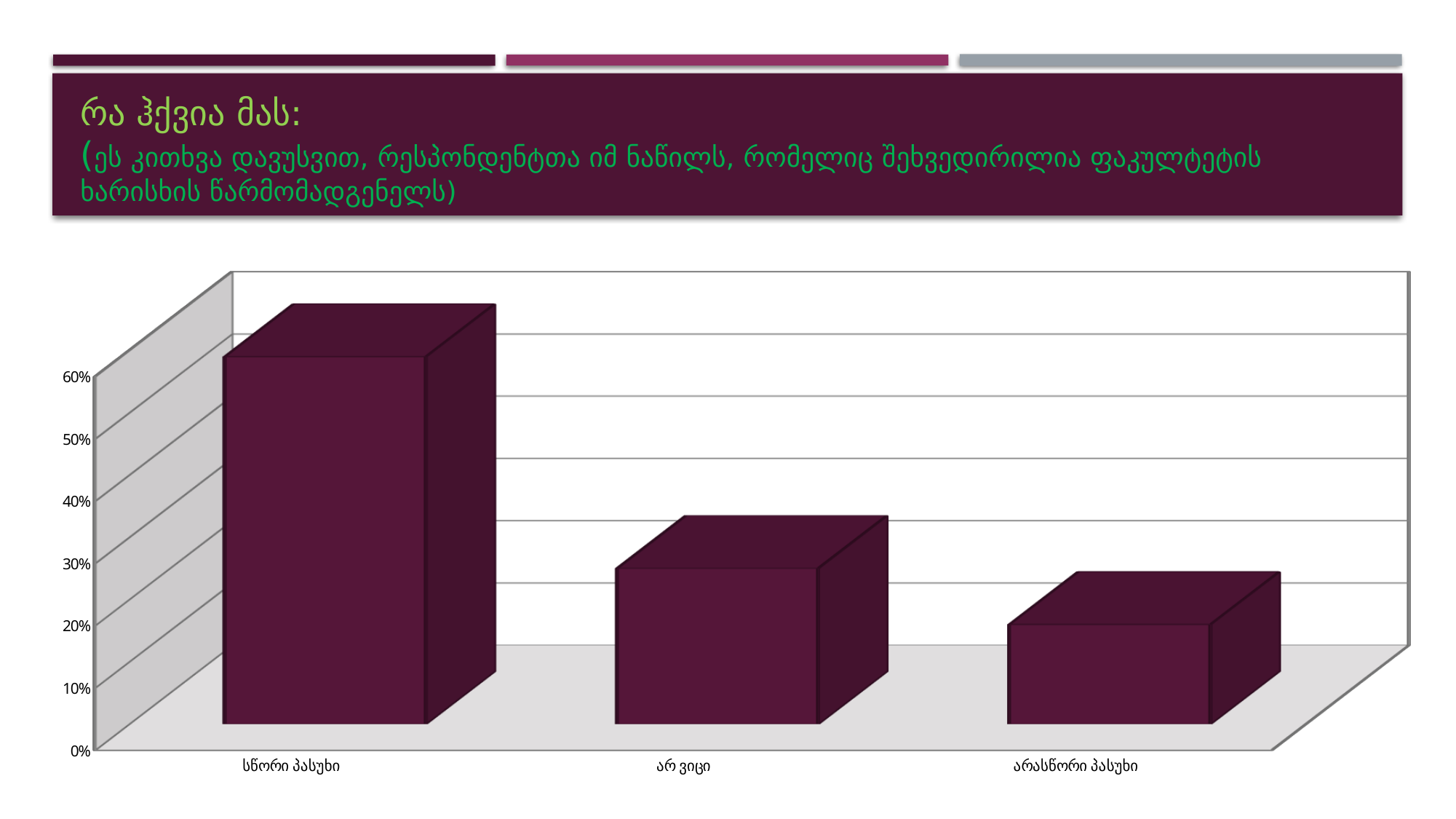
Is the value for არასწორი პასუხი greater or less than 30%? less Which is larger, the value for სწორი პასუხი or the value for არ ვიცი? სწორი პასუხი What kind of chart is shown on the slide? bar chart How many categories are shown on the x axis of the chart? 3 Is the value for არ ვიცი greater or less than 40%? less What is the main title text at the top of the slide? რა ჰქვია მას: Which category has the lowest bar? არასწორი პასუხი Is the value for არასწორი პასუხი greater or less than 10%? greater Which is larger, the value for არ ვიცი or the value for არასწორი პასუხი? არ ვიცი Do the bar values rise or fall from left to right along the x axis? fall Which category has the highest bar? სწორი პასუხი